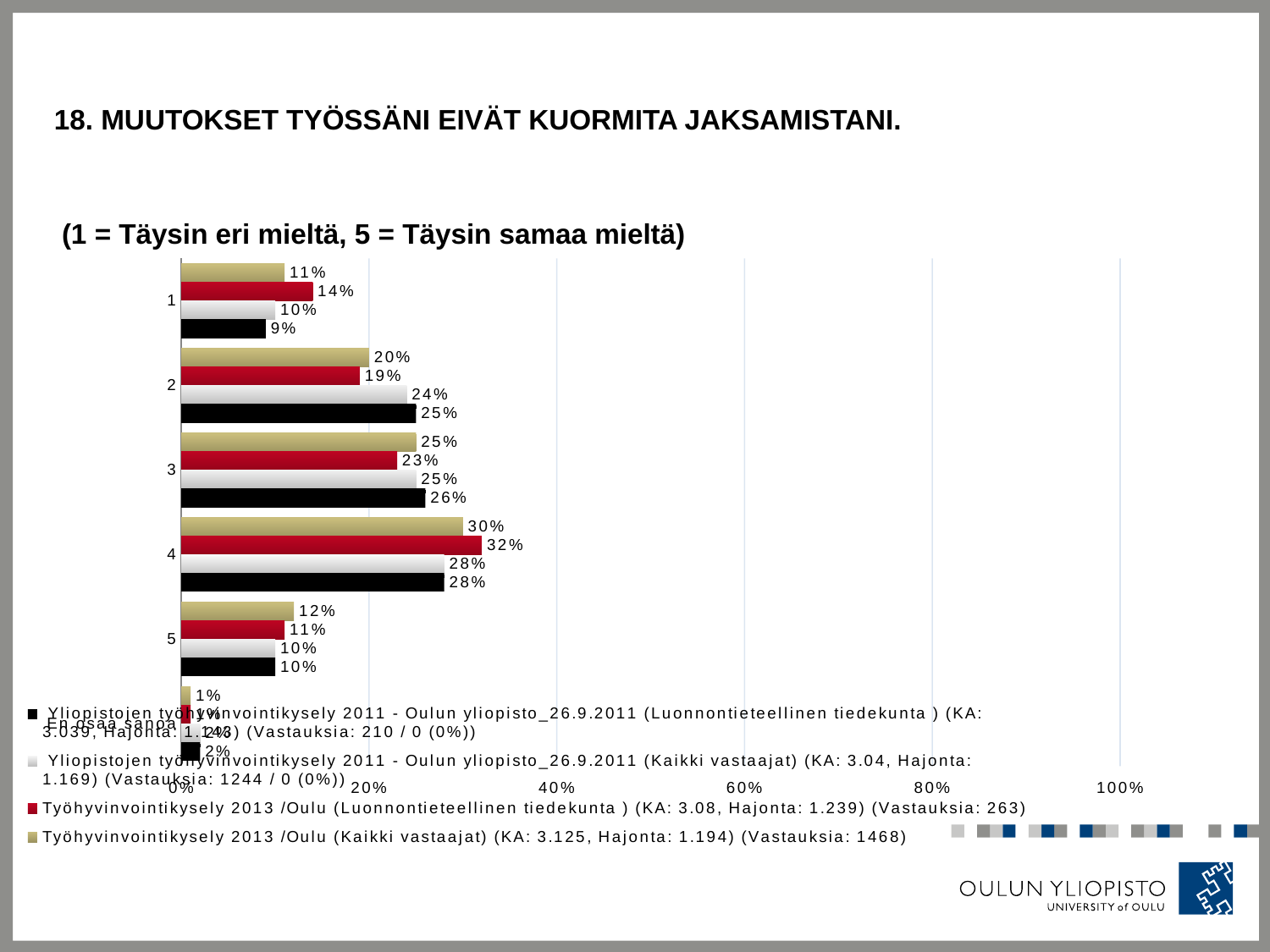
What is the value for category 5 in the Työhyvinvointikysely 2013 /Oulu (Kaikki vastaajat) series? 12% Is the value for category 4 in the Työhyvinvointikysely 2013 /Oulu (Kaikki vastaajat) series greater or less than 20%? greater What is the value for category 2 in the Yliopistojen työhyvinvointikysely 2011 (Kaikki vastaajat) series? 24% For category 4, what is the difference between the Työhyvinvointikysely 2013 /Oulu (Luonnontieteellinen tiedekunta) value and the Yliopistojen työhyvinvointikysely 2011 (Kaikki vastaajat) value? 4 percentage points What is the value for category 3 in the Yliopistojen työhyvinvointikysely 2011 (Luonnontieteellinen tiedekunta) series? 26% How many series does the legend list? 4 Among categories 1 to 5, which has the highest value in the Työhyvinvointikysely 2013 /Oulu (Kaikki vastaajat) series? 4 What is the value for category 4 in the Työhyvinvointikysely 2013 /Oulu (Luonnontieteellinen tiedekunta) series? 32% For category 2, which is larger: the 2011 Luonnontieteellinen tiedekunta value or the 2013 Luonnontieteellinen tiedekunta value? 2011 Luonnontieteellinen tiedekunta Among categories 1 to 5, which has the lowest value in the Yliopistojen työhyvinvointikysely 2011 (Luonnontieteellinen tiedekunta) series? 1 What is the title of the chart? 18. MUUTOKSET TYÖSSÄNI EIVÄT KUORMITA JAKSAMISTANI. What kind of chart is shown on the slide? bar chart